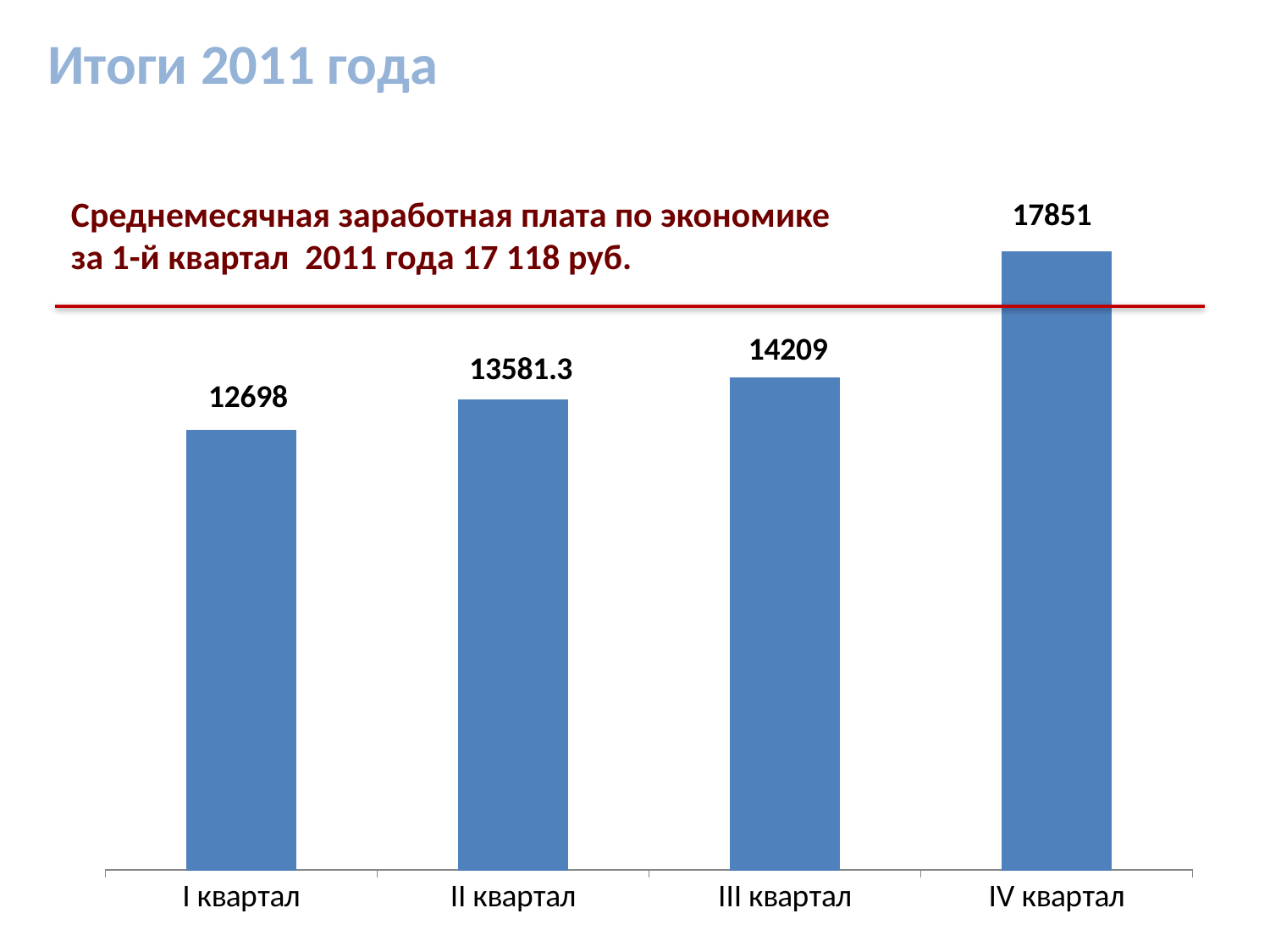
Which quarter has the lowest value? I квартал What kind of chart is shown on the slide? bar chart How many quarters are shown on the chart? 4 What is the value for II квартал? 13581.3 What is the value for IV квартал? 17851 Do the values rise or fall from I квартал to IV квартал? rise What is the value for I квартал? 12698 What is the difference between the values for III квартал and II квартал? 627.7 Which quarter has the highest value? IV квартал What is the value for III квартал? 14209 Which is larger, the value for II квартал or the value for III квартал? III квартал What is the difference between the values for IV квартал and I квартал? 5153